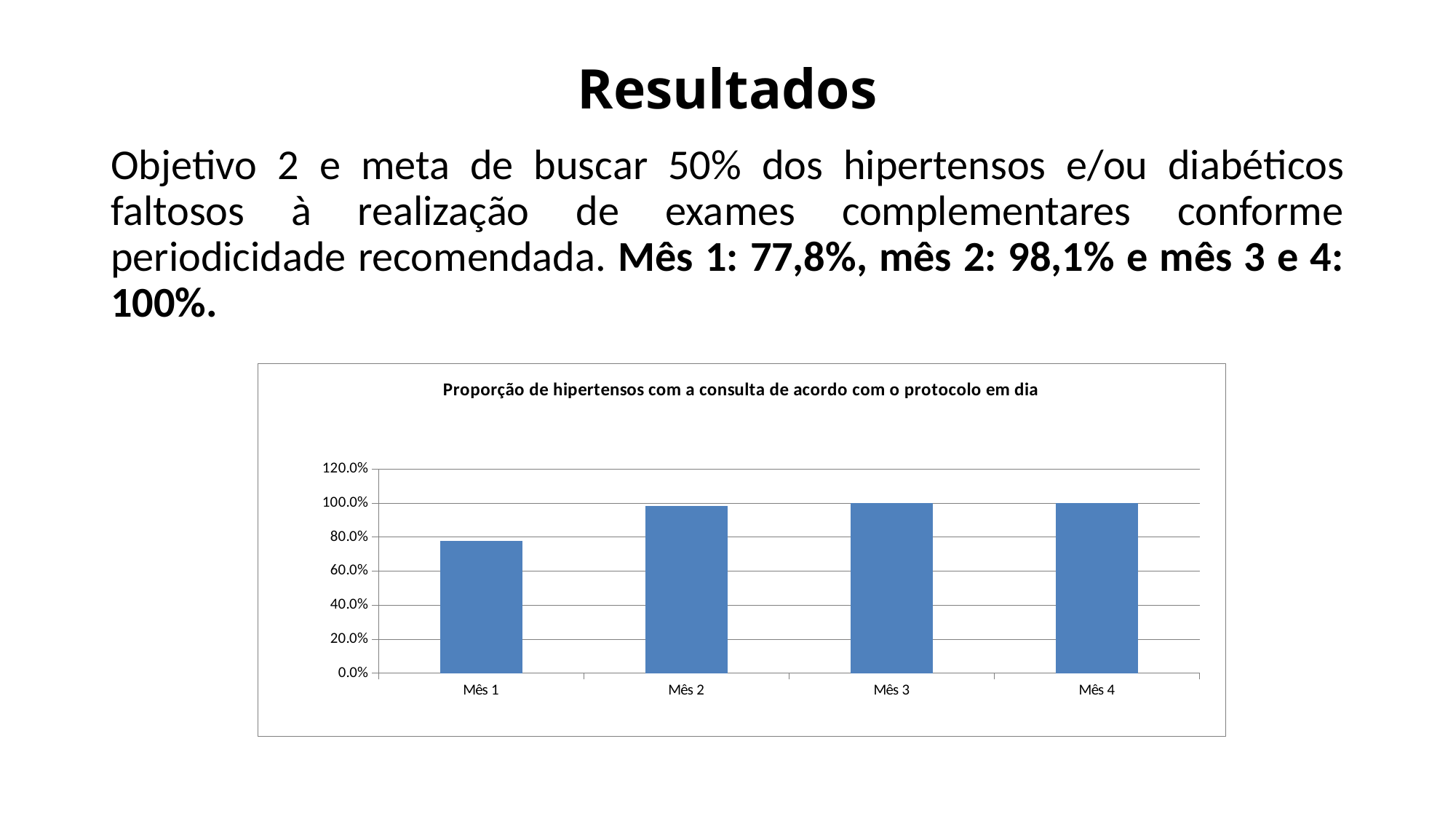
Which is larger, the value for Mês 1 or the value for Mês 2? Mês 2 What is the title of the chart? Proporção de hipertensos com a consulta de acordo com o protocolo em dia Do the values rise or fall from Mês 1 to Mês 4? rise Which month has the lowest value? Mês 1 What kind of chart is shown on the slide? bar chart What is the value for Mês 3? 100.0% Is the value for Mês 1 greater or less than 80.0%? less How many months (categories) are plotted on the chart? 4 Is the value for Mês 1 greater or less than 60.0%? greater What is the highest value shown on the vertical axis? 120.0% Is the value for Mês 2 greater or less than 80.0%? greater What is the value for Mês 4? 100.0%